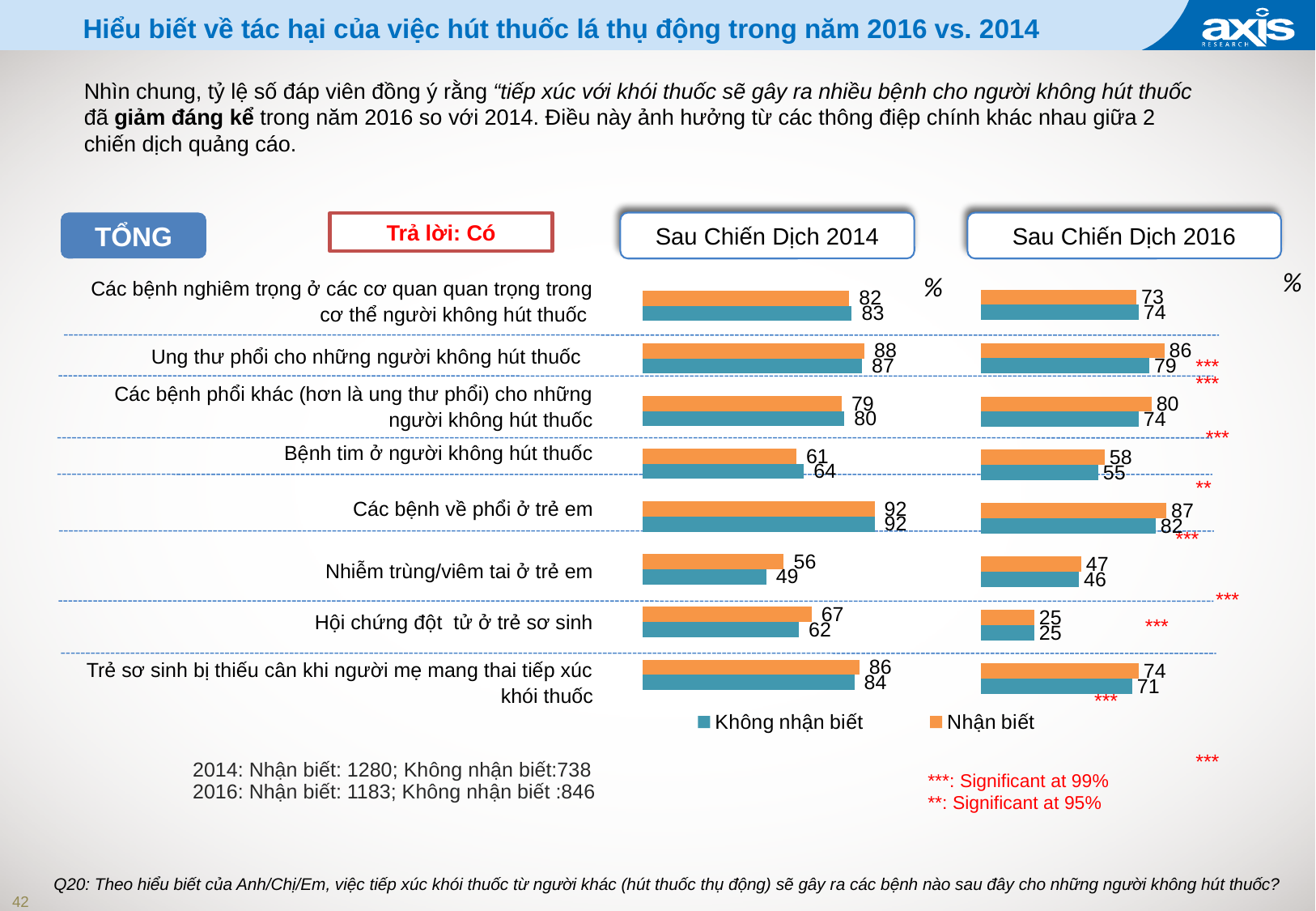
In the 'Sau Chiến Dịch 2014' chart, which category has the highest 'Nhận biết' value? Các bệnh về phổi ở trẻ em In the 'Sau Chiến Dịch 2014' chart, what is the difference between the 'Nhận biết' and 'Không nhận biết' values for 'Nhiễm trùng/viêm tai ở trẻ em'? 7 In the 'Sau Chiến Dịch 2016' chart, what is the difference between the 'Nhận biết' and 'Không nhận biết' values for 'Ung thư phổi cho những người không hút thuốc'? 7 How many categories are shown in the 'Sau Chiến Dịch 2016' chart? 8 In the 'Sau Chiến Dịch 2016' chart, which category has the lowest 'Nhận biết' value? Hội chứng đột tử ở trẻ sơ sinh In the 'Sau Chiến Dịch 2016' chart, what is the value for 'Không nhận biết' for 'Hội chứng đột tử ở trẻ sơ sinh'? 25 In the 'Sau Chiến Dịch 2014' chart, which is larger for 'Bệnh tim ở người không hút thuốc': 'Nhận biết' or 'Không nhận biết'? Không nhận biết Which colour represents 'Nhận biết' in the charts? Orange In the 'Sau Chiến Dịch 2016' chart, what is the value for 'Nhận biết' for 'Các bệnh về phổi ở trẻ em'? 87 How many series does the legend list for the charts? 2 In the 'Sau Chiến Dịch 2014' chart, what is the value for 'Nhận biết' for 'Ung thư phổi cho những người không hút thuốc'? 88 What type of chart is the 'Sau Chiến Dịch 2014' chart? Bar chart